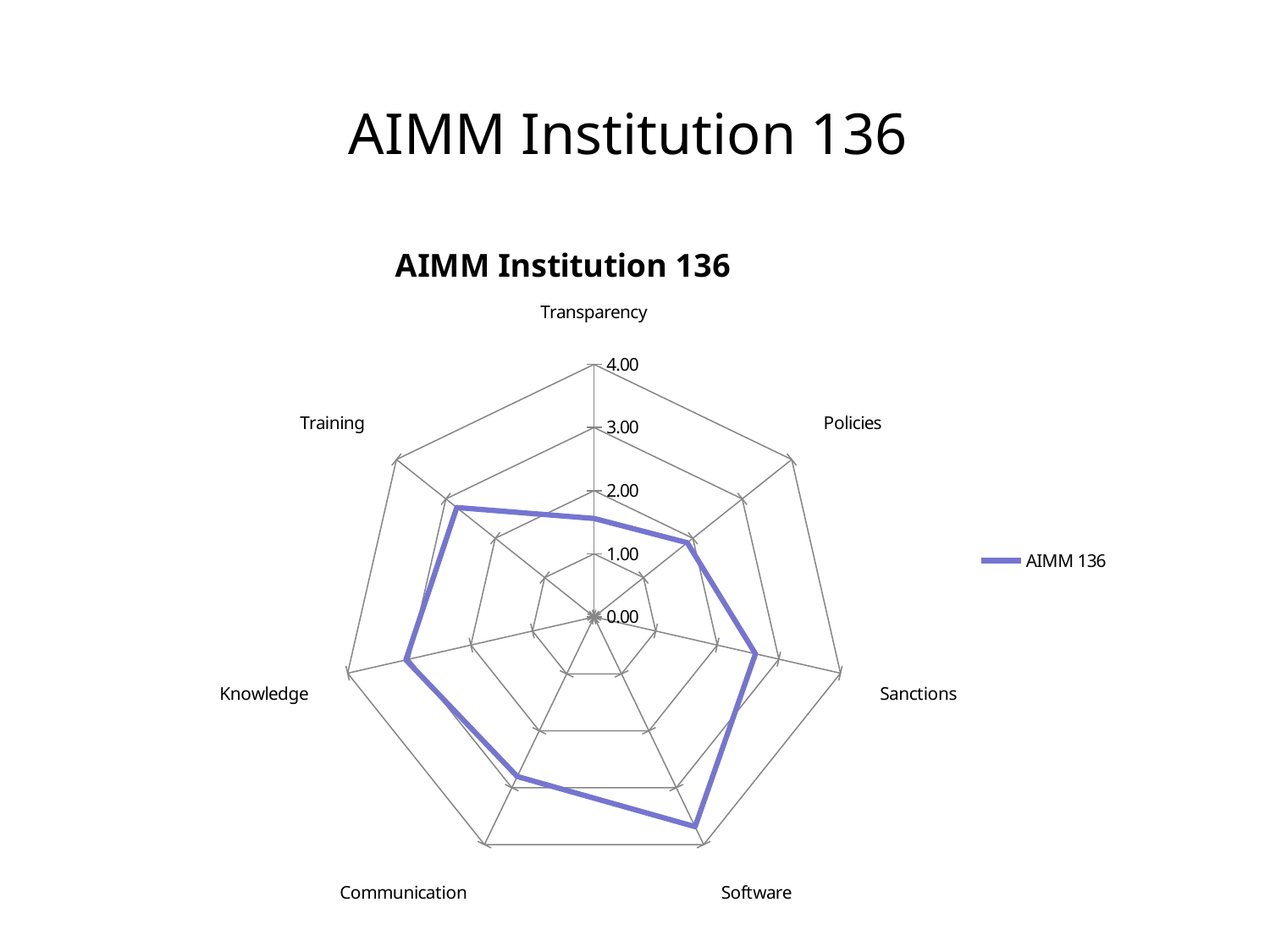
Which category has the lowest value for AIMM 136? Transparency Is the value for Software greater or less than 3.00? greater Which has the larger value, Knowledge or Policies? Knowledge What is the name of the series shown in the legend? AIMM 136 How many categories (axes) does the radar chart have? 7 Is the value for Transparency greater or less than 2.00? less What kind of chart is shown on the slide? Radar chart What is the highest value shown on the radar chart's axis scale? 4.00 Is the value for Sanctions greater or less than 2.00? greater How many series does the legend list? 1 Which category has the highest value for AIMM 136? Software Which has the larger value, Software or Transparency? Software